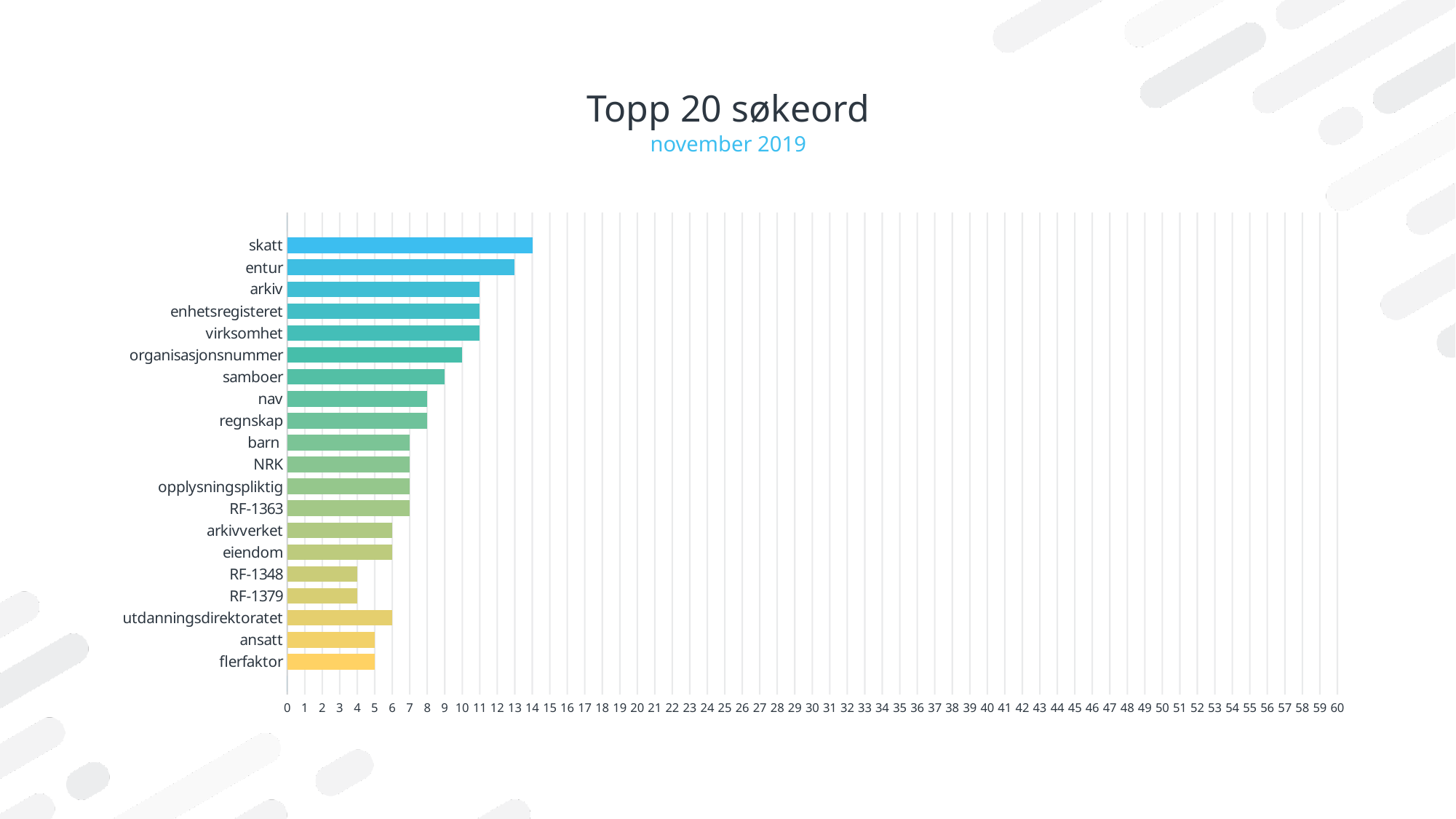
What is the value for entur? 13 Which is larger, the value for samboer or the value for nav? samboer Which search term has the highest value? skatt How many search terms (categories) are plotted in the chart? 20 What is the value for samboer? 9 Is the value for skatt greater or less than 20? less What is the title of the chart? Topp 20 søkeord What is the value for skatt? 14 What is the value for organisasjonsnummer? 10 What is the difference between the values for skatt and entur? 1 What is the value for RF-1348? 4 What kind of chart is shown on the slide? bar chart